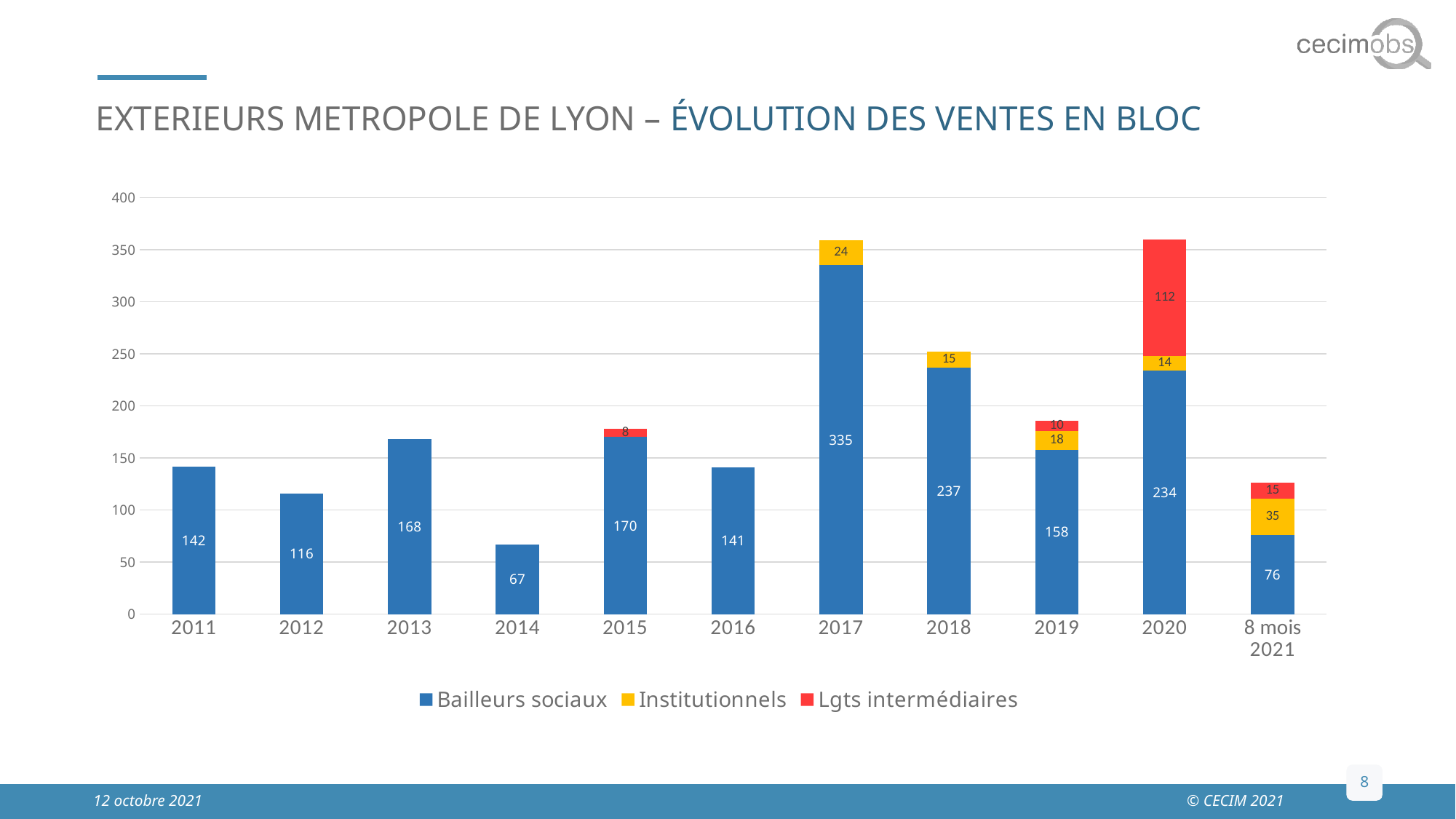
In which year is the Bailleurs sociaux value highest? 2017 In which year is the Bailleurs sociaux value lowest? 2014 How many categories are shown on the x axis? 11 What is the value for Bailleurs sociaux in 2017? 335 What is the value for Lgts intermédiaires in 2020? 112 How many series does the legend list? 3 What is the difference between the Bailleurs sociaux values for 2013 and 2012? 52 What is the total of the stacked bar for 2019? 186 What kind of chart is shown on the slide? Stacked bar chart What is the total of the stacked bar for 8 mois 2021? 126 What is the value for Institutionnels in 8 mois 2021? 35 Which year has the larger Bailleurs sociaux value, 2018 or 2019? 2018